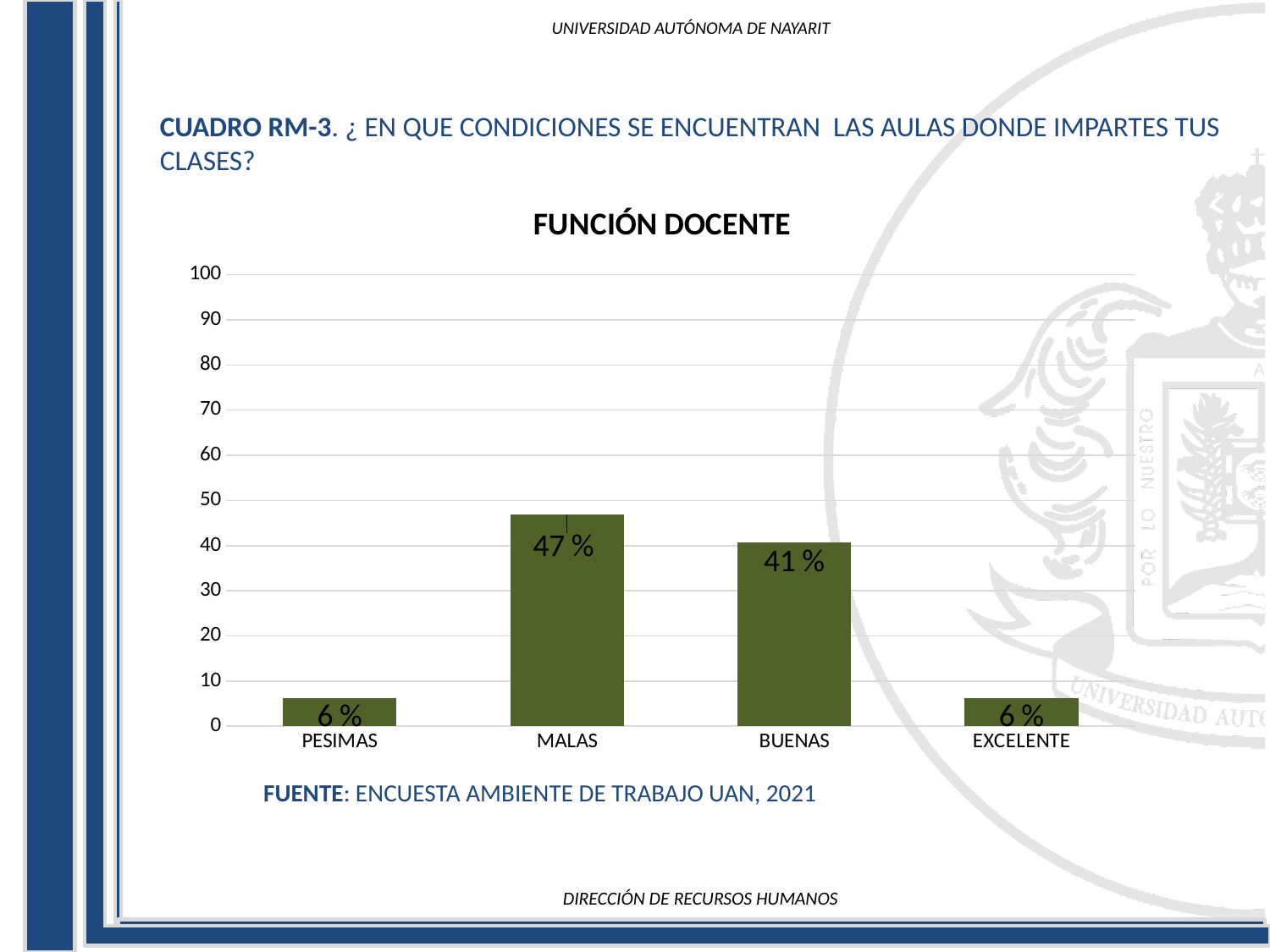
What is the value for PESIMAS? 6 % What is the value for EXCELENTE? 6 % What is the title of the chart? FUNCIÓN DOCENTE Is the value for BUENAS greater or less than 50? less What is the difference between the values for BUENAS and EXCELENTE? 35 % What is the value for MALAS? 47 % What kind of chart is shown on the slide? bar chart Which is larger, the value for MALAS or the value for BUENAS? MALAS How many categories are shown on the x axis? 4 Which category has the highest value? MALAS What is the value for BUENAS? 41 % What is the difference between the values for MALAS and BUENAS? 6 %